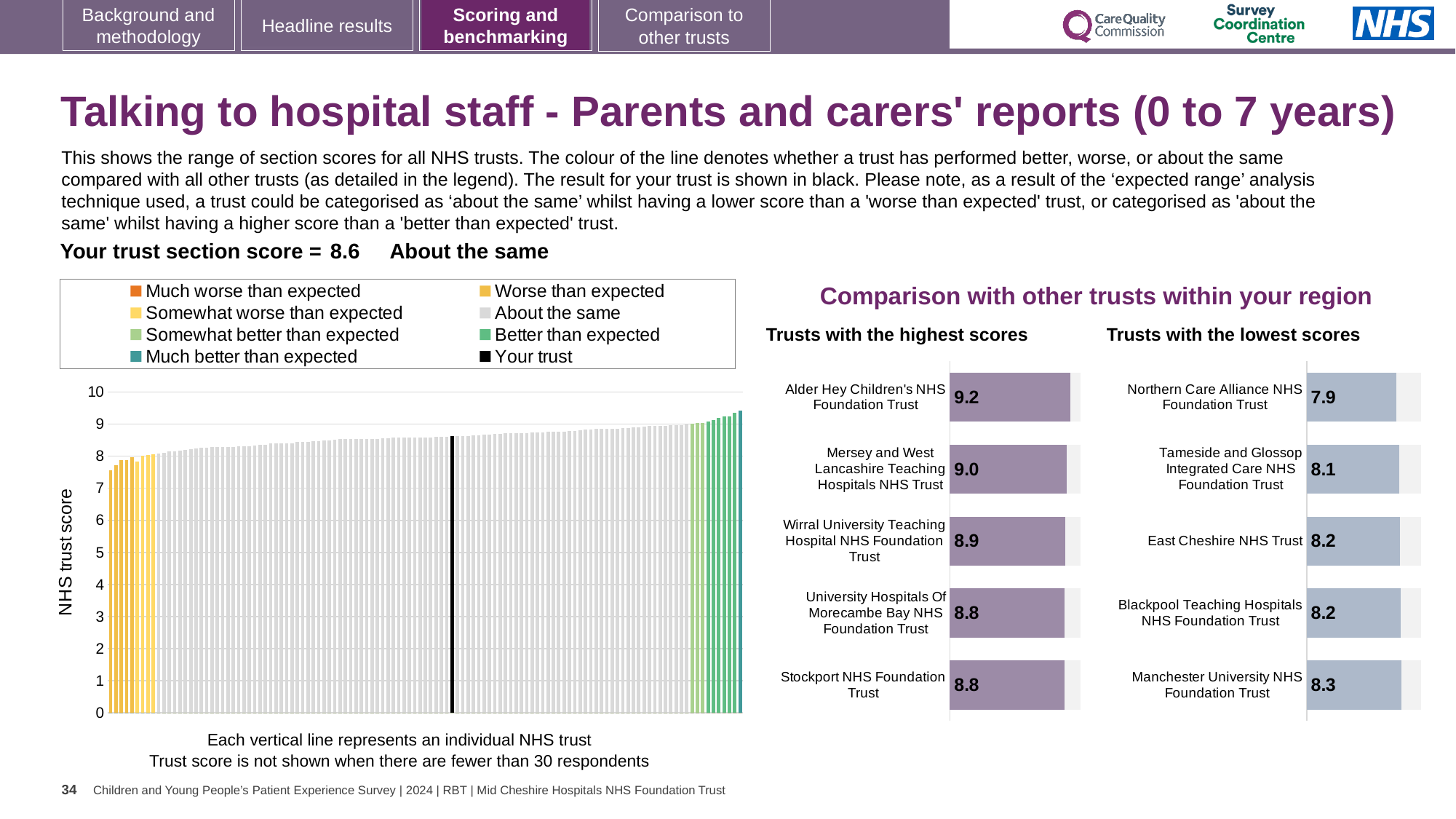
In the 'Trusts with the highest scores' chart, what is the score for Alder Hey Children's NHS Foundation Trust? 9.2 In the 'Trusts with the lowest scores' chart, what is the score for Northern Care Alliance NHS Foundation Trust? 7.9 In the left chart of all NHS trusts, what is the section score for your trust (the black line)? 8.6 In the 'Trusts with the highest scores' chart, which trust has the highest score? Alder Hey Children's NHS Foundation Trust In the 'Trusts with the lowest scores' chart, which trust has the lowest score? Northern Care Alliance NHS Foundation Trust In the 'Trusts with the lowest scores' chart, what is the score for East Cheshire NHS Trust? 8.2 In the 'Trusts with the highest scores' chart, what is the difference between the scores of Alder Hey Children's NHS Foundation Trust and Stockport NHS Foundation Trust? 0.4 How many entries does the legend above the left chart list? 8 In the left chart of all NHS trusts, do the values rise or fall from left to right along the x axis? rise In the 'Trusts with the highest scores' chart, how many trusts are shown? 5 In the 'Trusts with the lowest scores' chart, which has the larger score: Manchester University NHS Foundation Trust or Tameside and Glossop Integrated Care NHS Foundation Trust? Manchester University NHS Foundation Trust In the left chart of all NHS trusts, is the value of the leftmost (lowest) bar greater or less than 8? less